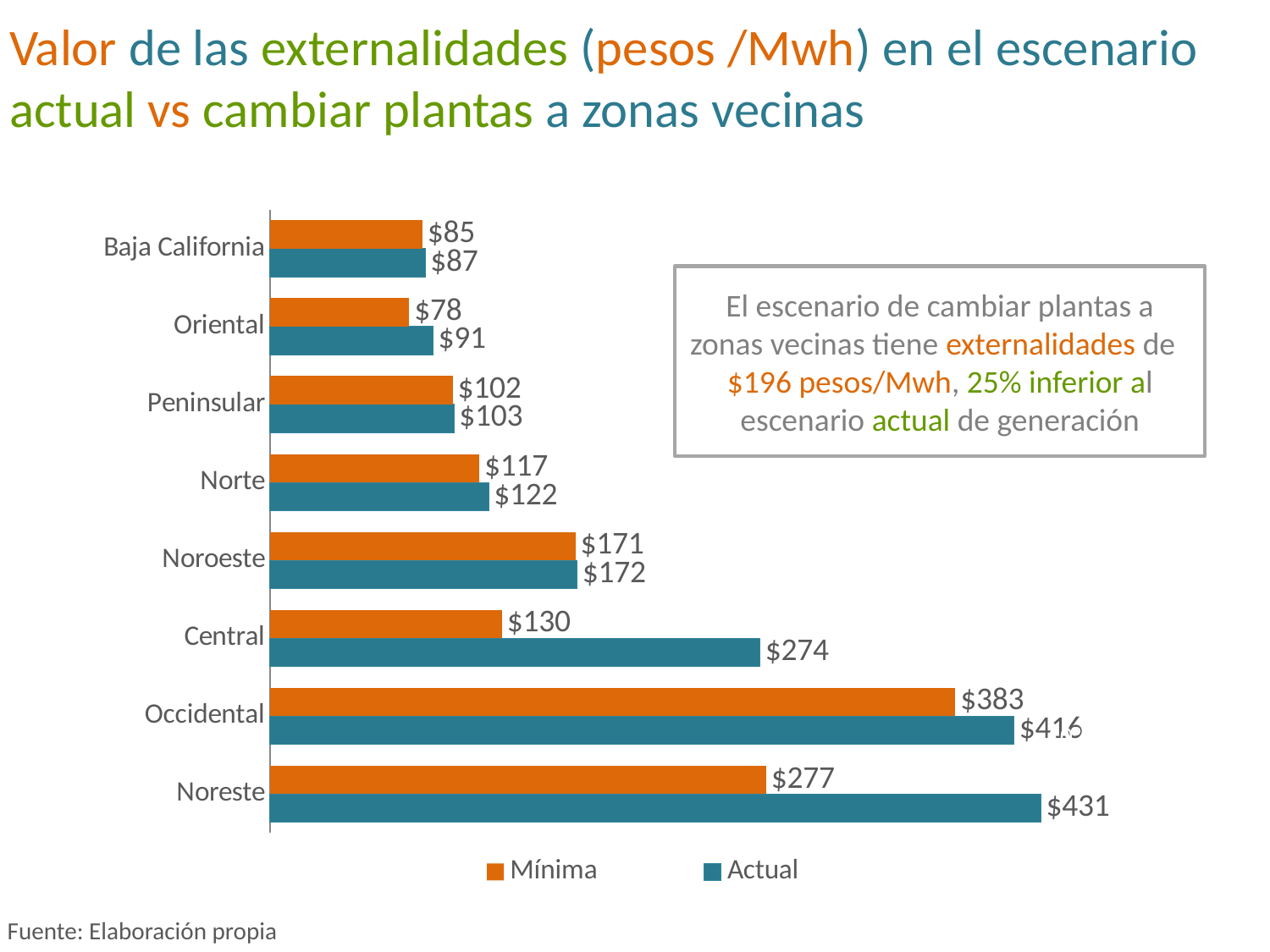
What is the difference between the Actual and Mínima values for Central? $144 What kind of chart is shown on the slide? Bar chart Which category has the highest Actual value? Noreste What is the Actual value for Noreste? $431 Which is larger, the Mínima value for Occidental or the Mínima value for Noreste? Occidental What is the Actual value for Oriental? $91 What is the Mínima value for Central? $130 Which category has the lowest Mínima value? Oriental What is the difference between the Actual and Mínima values for Noreste? $154 What is the Mínima value for Noroeste? $171 How many series does the legend list? 2 How many categories are shown on the chart? 8